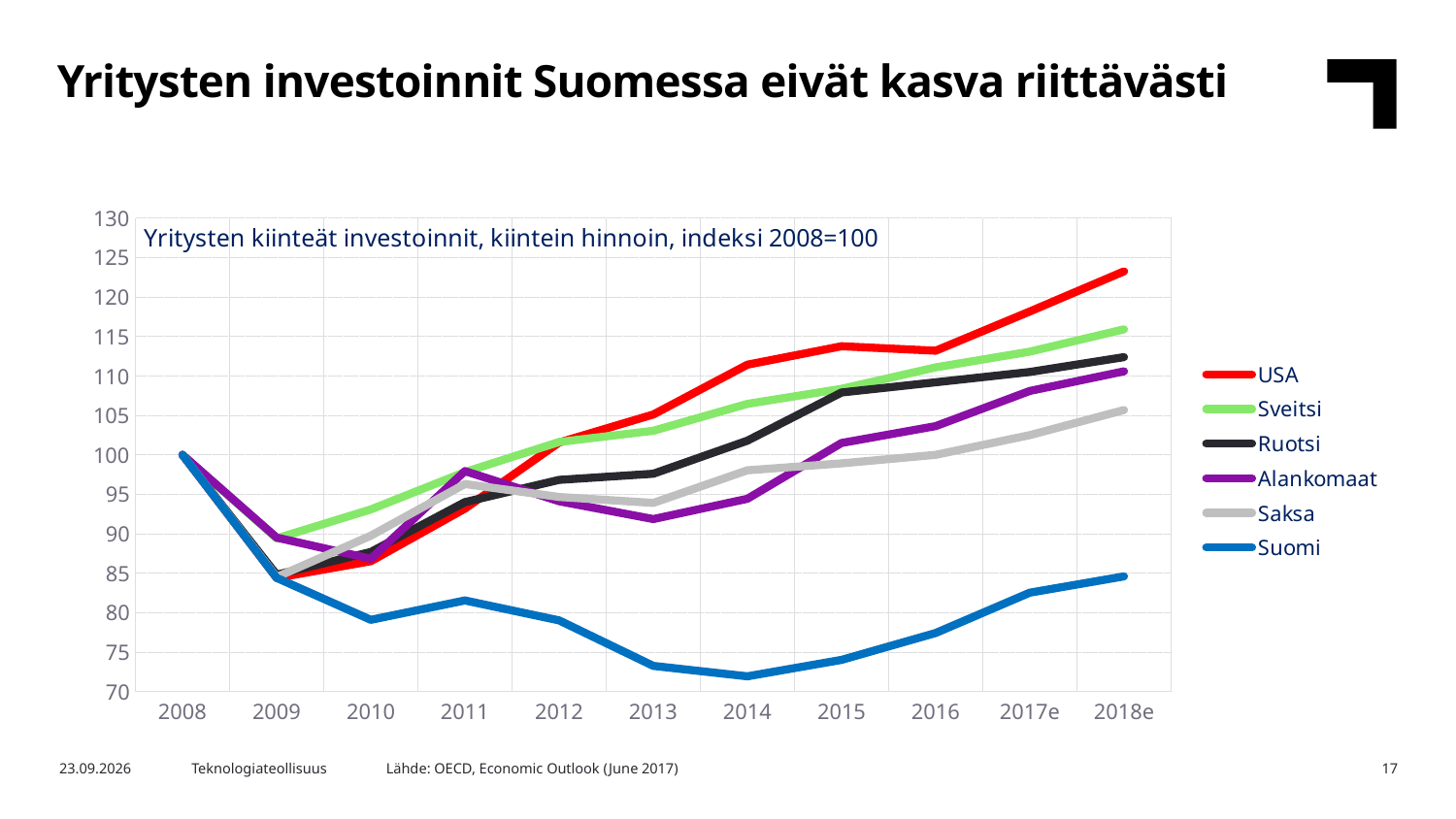
What is the title shown inside the chart area? Yritysten kiinteät investoinnit, kiintein hinnoin, indeksi 2008=100 What is the index value for Suomi in 2008? 100 What kind of chart is shown on the slide? line chart Is the value for Suomi in 2014 greater or less than 75? less Is the value for Ruotsi in 2015 greater or less than 105? greater Which series has the highest value in 2018e? USA Which series has the lowest value in 2018e? Suomi Does the Suomi line rise or fall from 2008 to 2014? fall How many years are shown along the x axis? 11 In 2016, which is larger: the value for USA or the value for Saksa? USA Is the value for USA in 2018e greater or less than 120? greater How many series does the legend list? 6